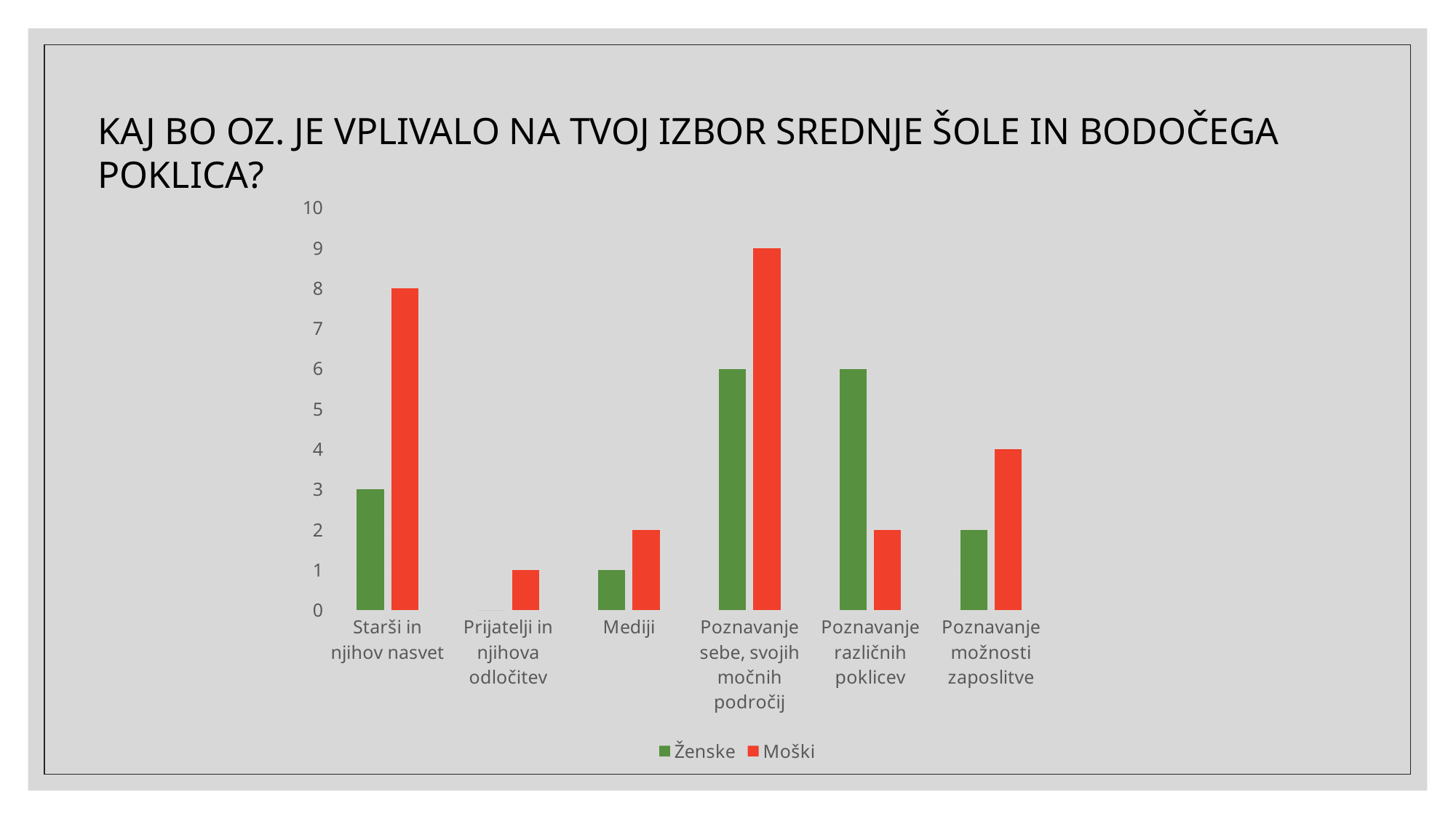
What kind of chart is shown on the slide? bar chart How many series does the legend list? 2 How many categories are shown on the x axis? 6 Which category has the lowest value for Moški? Prijatelji in njihova odločitev Is the value for Moški in Poznavanje sebe, svojih močnih področij greater or less than 5? greater What is the value for Moški in the category Starši in njihov nasvet? 8 Which is larger for Poznavanje različnih poklicev: the Ženske value or the Moški value? Ženske What is the value for Ženske in the category Poznavanje sebe, svojih močnih področij? 6 What is the difference between the Moški and Ženske values for Starši in njihov nasvet? 5 Which category has the highest value for Moški? Poznavanje sebe, svojih močnih področij Which colour represents the Ženske series? green What is the value for Moški in the category Poznavanje možnosti zaposlitve? 4